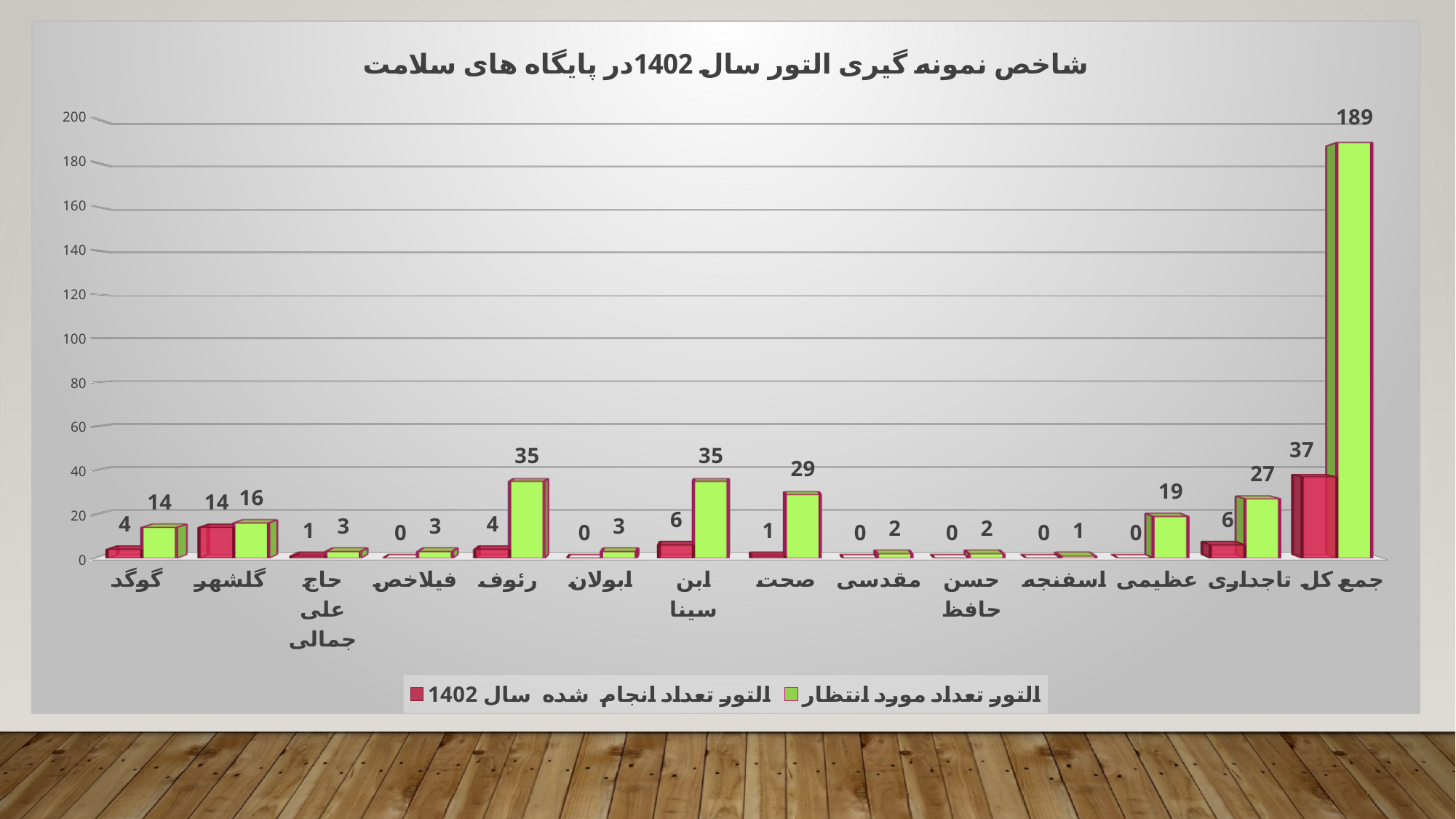
What is the performed in 1402 (التور تعداد مورد انجام شده سال 1402) value for گلشهر? 14 Which category has the highest expected (التور تعداد انتظار) value? جمع کل What type of chart is shown on the slide? bar chart Which is larger for تاجداری: the expected value or the performed value? the expected value (27) What is the expected (التور تعداد انتظار) value for رئوف? 35 Which category has the lowest expected (التور تعداد انتظار) value? اسفنجه Is the expected value for جمع کل greater or less than 180? greater What is the expected (التور تعداد انتظار) value for جمع کل? 189 How many categories are shown on the x axis? 14 What colour are the bars for the expected (التور تعداد انتظار) series? green What is the difference between the expected and performed values for صحت? 28 How many series does the legend list? 2